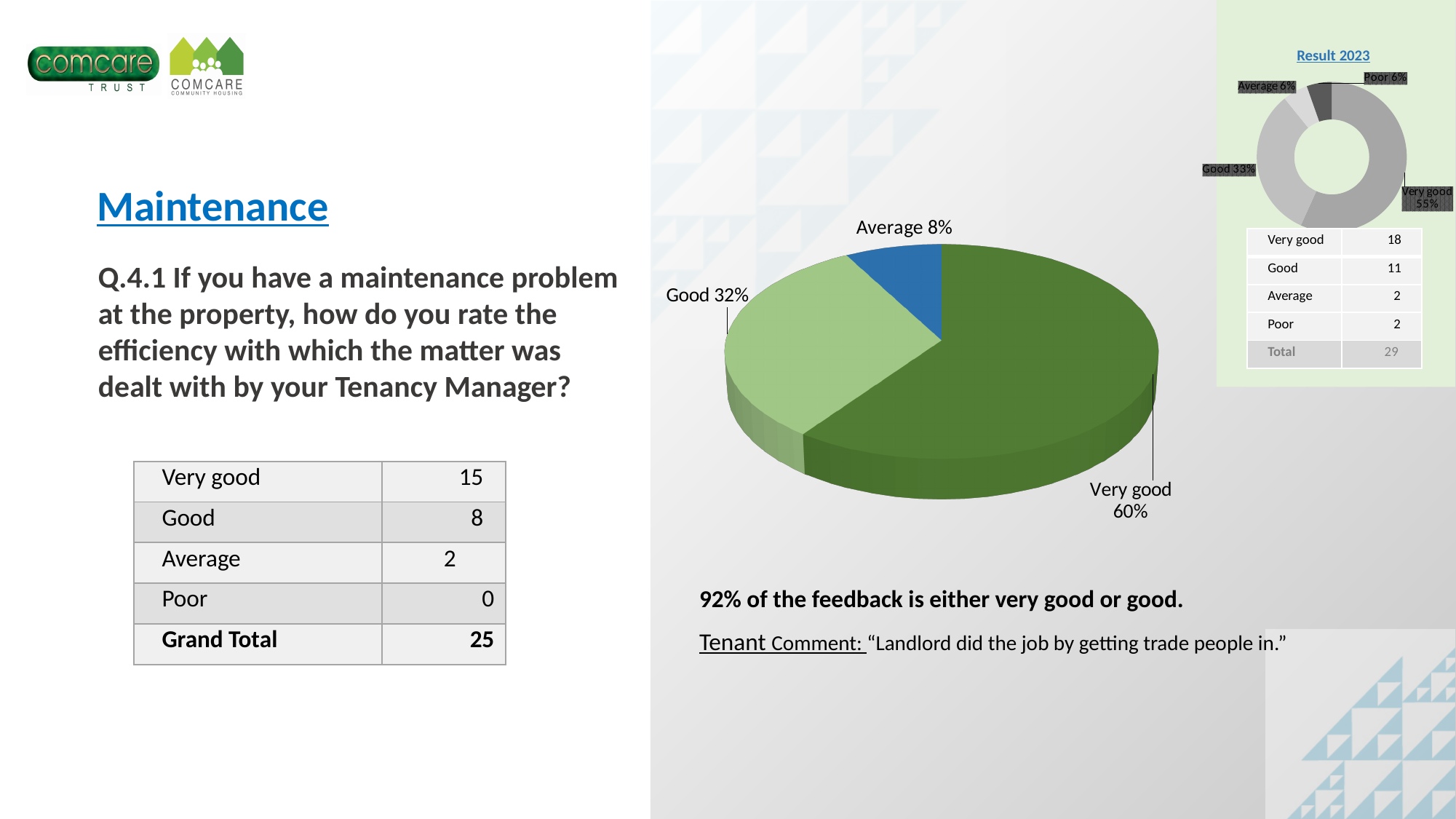
On the large pie chart in the centre of the slide, what is the difference in percentage points between the Very good and Good slices? 28 On the Result 2023 donut chart in the top right, how many categories are shown? 4 On the large pie chart in the centre of the slide, how many slices are shown? 3 On the large pie chart in the centre of the slide, what share is labelled for Good? 32% What kind of chart is the large chart in the centre of the slide? Pie chart On the Result 2023 donut chart in the top right, which is larger, the Good slice or the Average slice? Good On the large pie chart in the centre of the slide, what share is labelled for Average? 8% On the Result 2023 donut chart in the top right, what share is labelled for Good? 33% On the large pie chart in the centre of the slide, which category has the smallest slice? Average On the large pie chart in the centre of the slide, which category has the largest slice? Very good